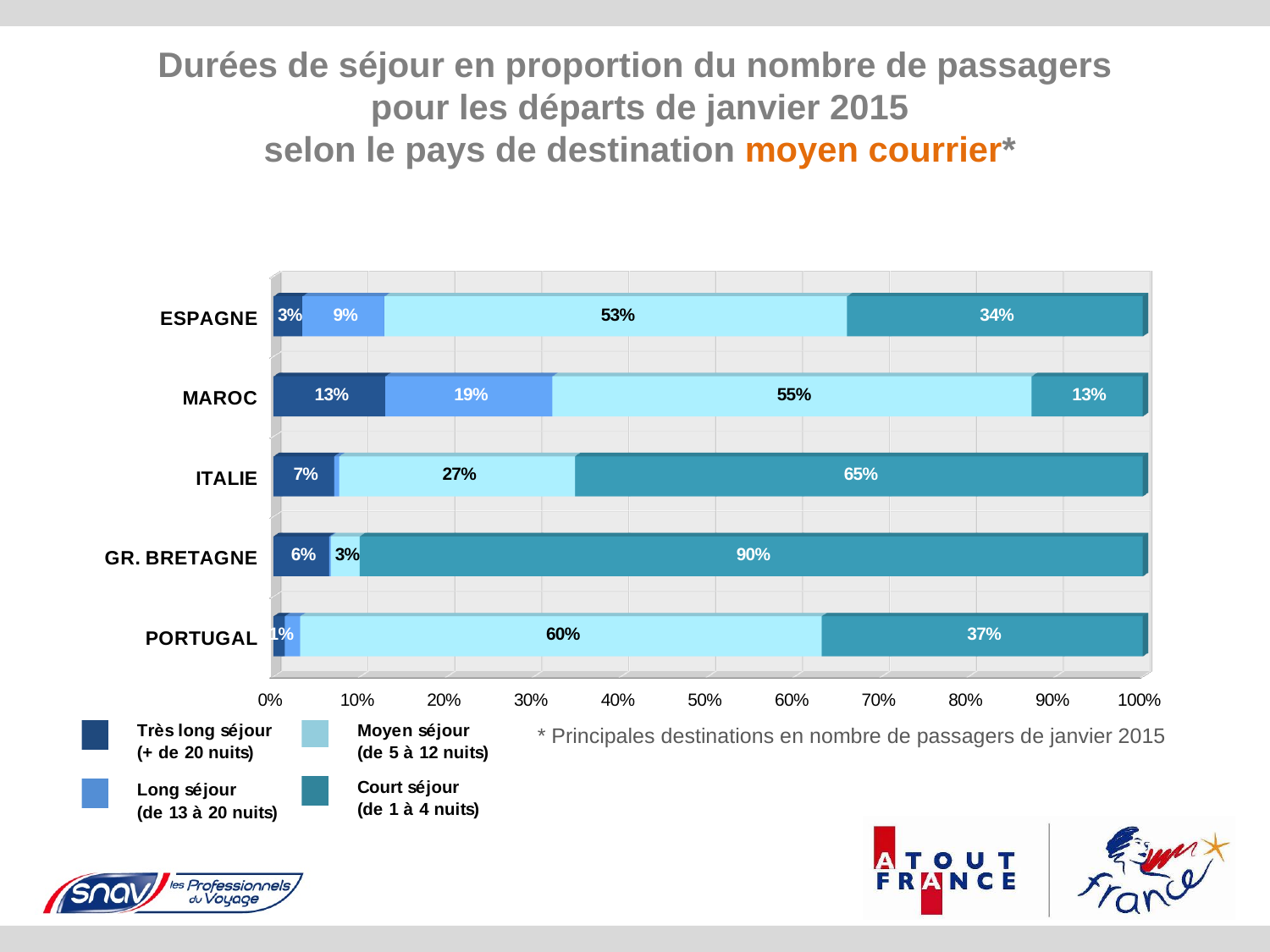
Which country has the lowest Court séjour (de 1 à 4 nuits) share? MAROC What is the Moyen séjour (de 5 à 12 nuits) share for MAROC? 55% What is the Très long séjour (+ de 20 nuits) share for ESPAGNE? 3% What is the Court séjour (de 1 à 4 nuits) share for GR. BRETAGNE? 90% Which country has the highest Court séjour (de 1 à 4 nuits) share? GR. BRETAGNE How many countries are shown on the chart? 5 Which has the larger Court séjour share, ESPAGNE or PORTUGAL? PORTUGAL What is the difference between the Moyen séjour share for PORTUGAL and for ITALIE? 33 percentage points Which country has the highest Très long séjour (+ de 20 nuits) share? MAROC What is the Long séjour (de 13 à 20 nuits) share for MAROC? 19% How many series does the legend list? 4 What kind of chart is shown on the slide? Stacked bar chart